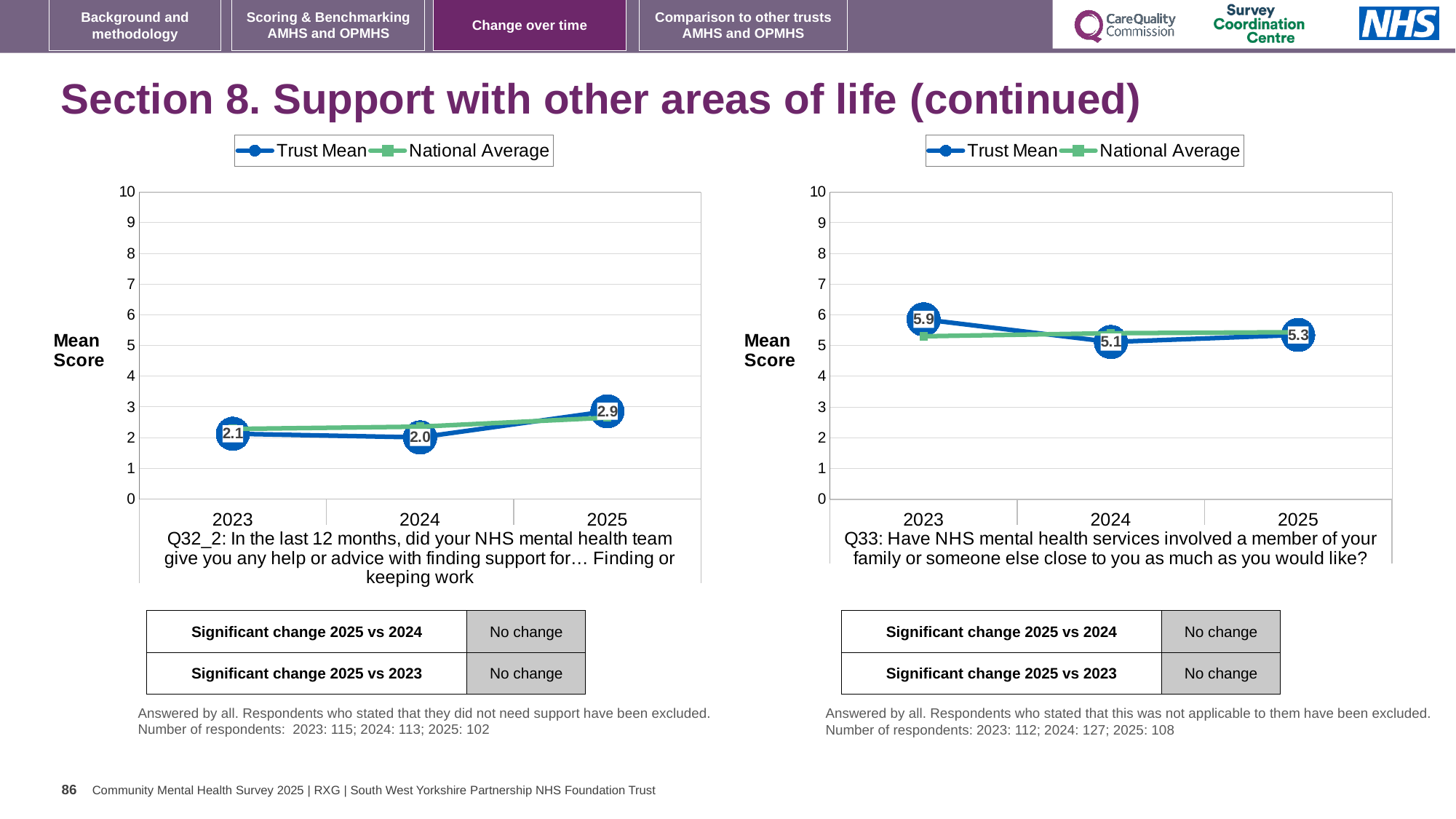
In the right chart (Q33), what is the difference between the Trust Mean for 2023 and 2024? 0.8 How many series does the legend of the right chart (Q33) list? 2 In the right chart (Q33), is the Trust Mean for 2023 greater or less than 5? greater In the left chart (Q32_2), what is the difference between the Trust Mean for 2025 and 2024? 0.9 How many years are plotted on the x axis of the left chart (Q32_2)? 3 In the right chart (Q33), what is the Trust Mean for 2025? 5.3 In the right chart (Q33), which year has the lowest Trust Mean? 2024 In the left chart (Q32_2), what is the Trust Mean for 2024? 2.0 In the right chart (Q33), what is the Trust Mean for 2023? 5.9 In the left chart (Q32_2), what is the Trust Mean for 2025? 2.9 In the left chart (Q32_2), which year has the highest Trust Mean? 2025 What kind of chart is the left chart (Q32_2)? Line chart